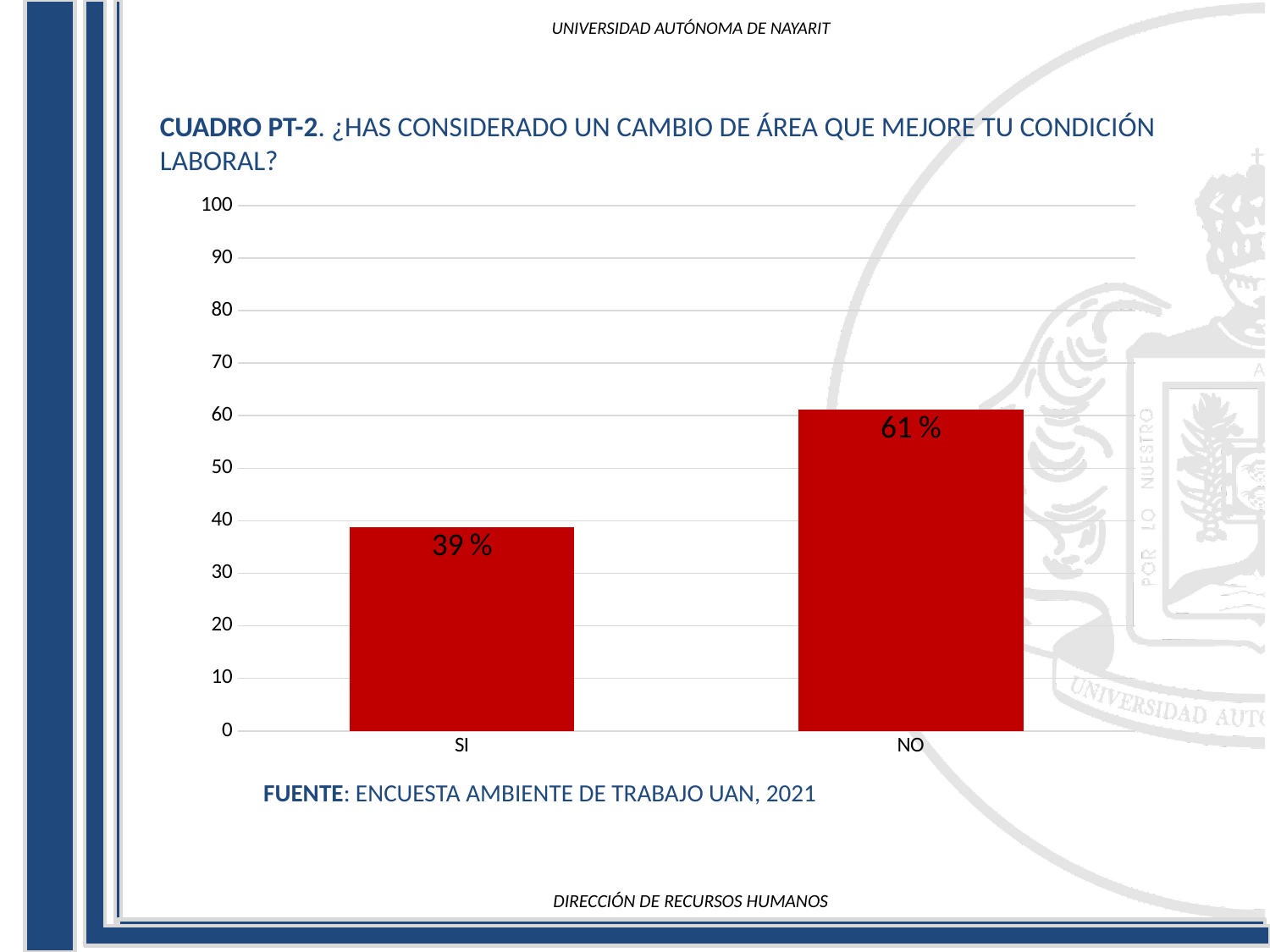
Which category has the lowest value? SI How many categories are shown on the x axis? 2 Is the value for SI greater or less than 40? less Is the value for NO greater or less than 60? greater Which is larger, the value for SI or the value for NO? NO What is the highest value shown on the y axis? 100 What colour are the bars in the chart? red What is the difference between the values for NO and SI? 22 % What kind of chart is shown on the slide? bar chart Which category has the highest value? NO What is the value for NO? 61 % What is the value for SI? 39 %